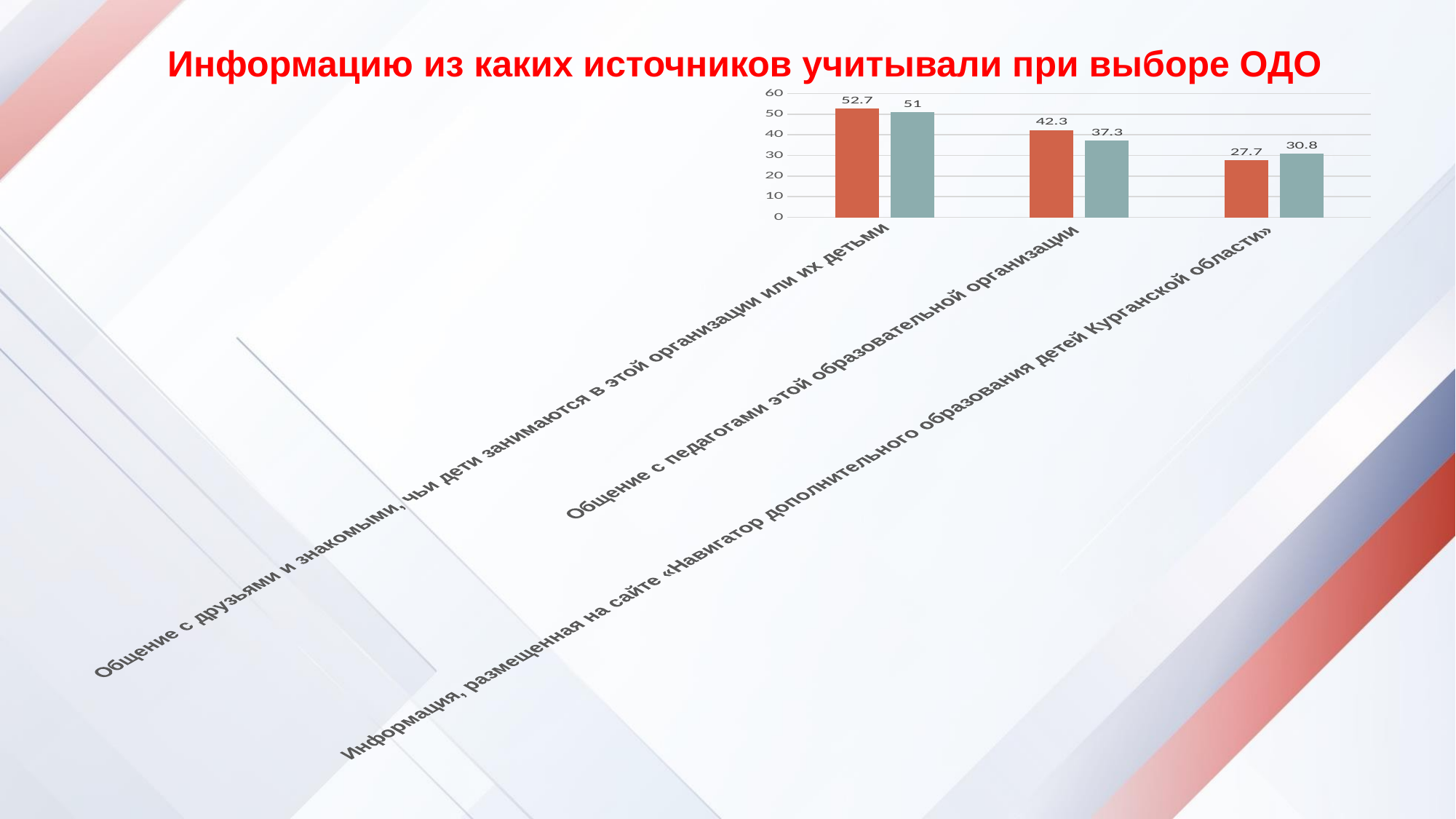
What is the difference between the orange and teal bars for «Общение с педагогами этой образовательной организации»? 5 What is the value of the teal bar for «Информация, размещенная на сайте «Навигатор дополнительного образования детей Курганской области»»? 30.8 Which category has the lowest orange bar? Информация, размещенная на сайте «Навигатор дополнительного образования детей Курганской области» What is the value of the orange bar for «Общение с педагогами этой образовательной организации»? 42.3 How many categories are shown on the x axis of the chart? 3 Is the teal bar for «Общение с педагогами этой образовательной организации» greater or less than 40? less For «Информация, размещенная на сайте «Навигатор дополнительного образования детей Курганской области»», which bar is larger, the orange or the teal one? teal What is the value of the teal bar for «Общение с друзьями и знакомыми, чьи дети занимаются в этой организации или их детьми»? 51 Which category has the highest orange bar? Общение с друзьями и знакомыми, чьи дети занимаются в этой организации или их детьми What is the title of the slide above the chart? Информацию из каких источников учитывали при выборе ОДО What is the value of the orange bar for «Общение с друзьями и знакомыми, чьи дети занимаются в этой организации или их детьми»? 52.7 What kind of chart is shown on the slide? bar chart